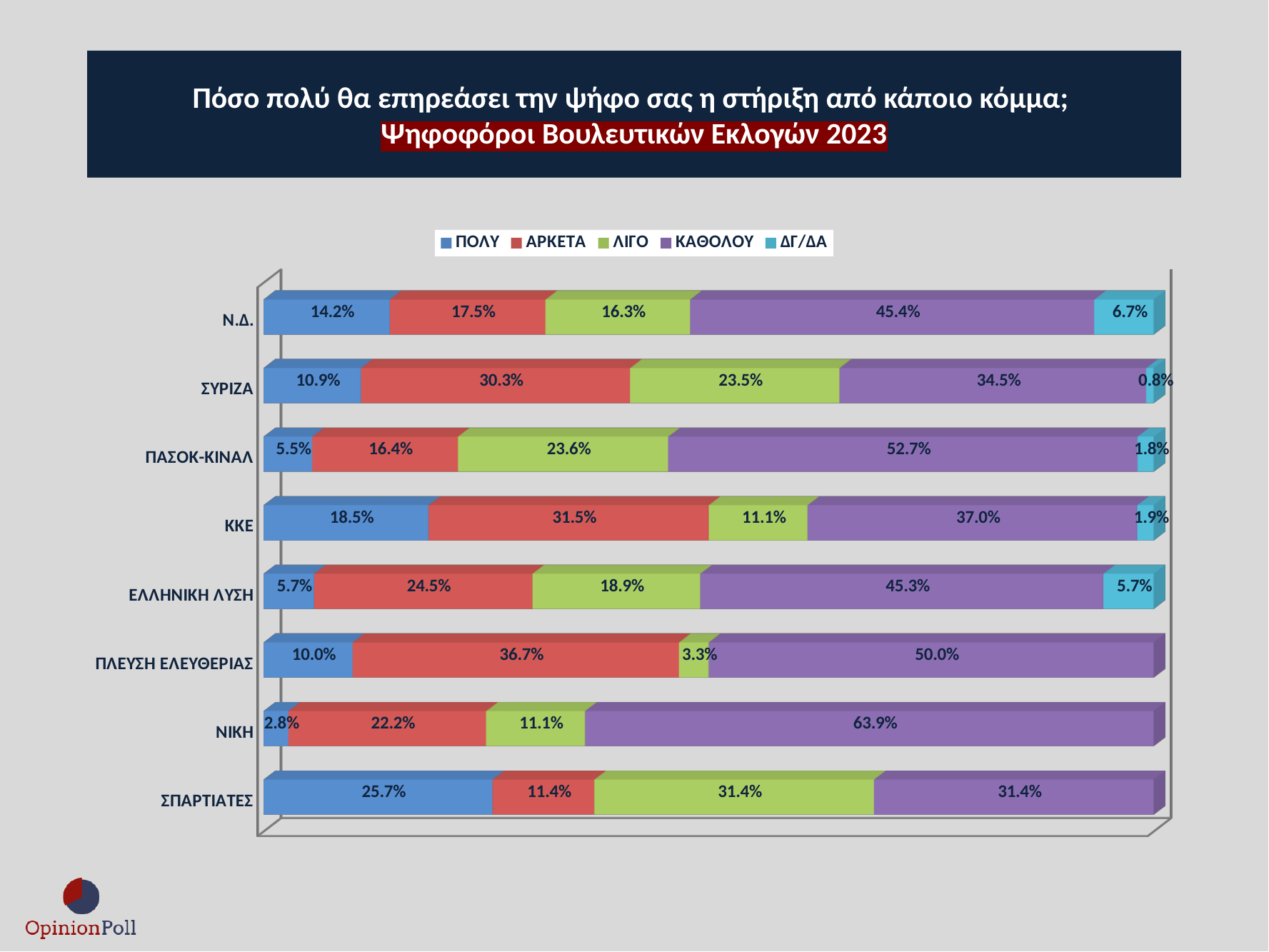
How many series does the legend list? 5 What percentage of Ν.Δ. voters answered ΚΑΘΟΛΟΥ? 45.4% Which party has the highest ΚΑΘΟΛΟΥ value? ΝΙΚΗ Which party has the highest ΠΟΛΥ value? ΣΠΑΡΤΙΑΤΕΣ Which has the larger ΚΑΘΟΛΟΥ value, ΠΑΣΟΚ-ΚΙΝΑΛ or ΠΛΕΥΣΗ ΕΛΕΥΘΕΡΙΑΣ? ΠΑΣΟΚ-ΚΙΝΑΛ Which party has the lowest ΠΟΛΥ value? ΝΙΚΗ What is the ΑΡΚΕΤΑ value for ΣΥΡΙΖΑ? 30.3% What is the ΔΓ/ΔΑ value for ΕΛΛΗΝΙΚΗ ΛΥΣΗ? 5.7% What is the total of the ΣΠΑΡΤΙΑΤΕΣ bar? 99.9% What kind of chart is shown on the slide? Stacked bar chart How many parties are shown on the chart? 8 What is the difference between the ΑΡΚΕΤΑ value for ΚΚΕ and the ΑΡΚΕΤΑ value for ΣΥΡΙΖΑ? 1.2 percentage points